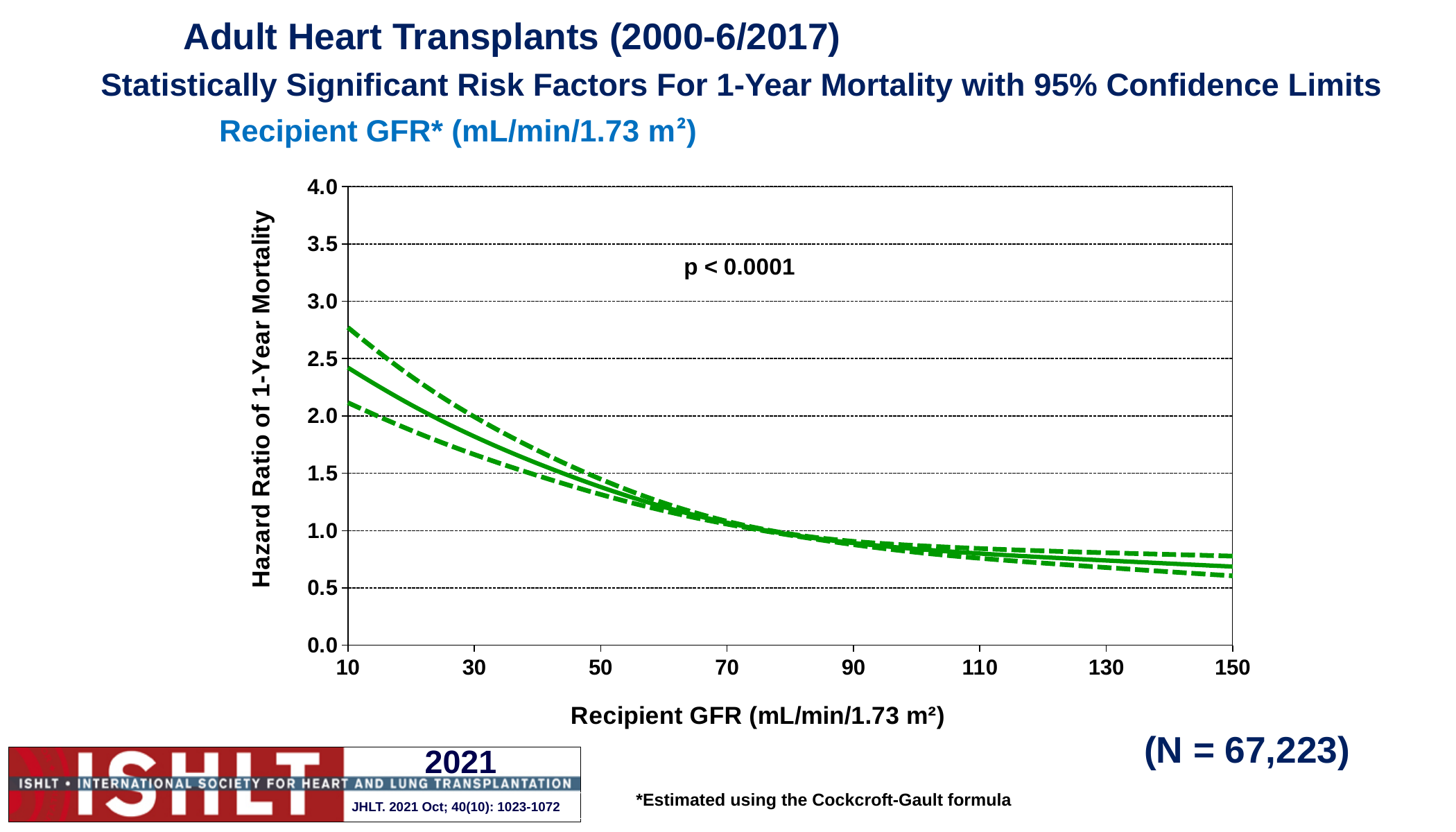
Is the hazard ratio on the solid line at a recipient GFR of 30 greater or less than 1.5? greater What kind of chart is shown on the slide? Line chart Does the hazard ratio of 1-year mortality rise or fall as recipient GFR increases along the x axis? Fall Is the hazard ratio on the solid line at a recipient GFR of 10 greater or less than 2.0? greater Is the hazard ratio on the solid line higher at a recipient GFR of 10 or at a recipient GFR of 90? 10 Is the hazard ratio on the solid line at a recipient GFR of 150 greater or less than 1.0? less What p-value is printed on the chart? p < 0.0001 What is the label of the y axis? Hazard Ratio of 1-Year Mortality How many lines (solid and dashed) are plotted on the chart? 3